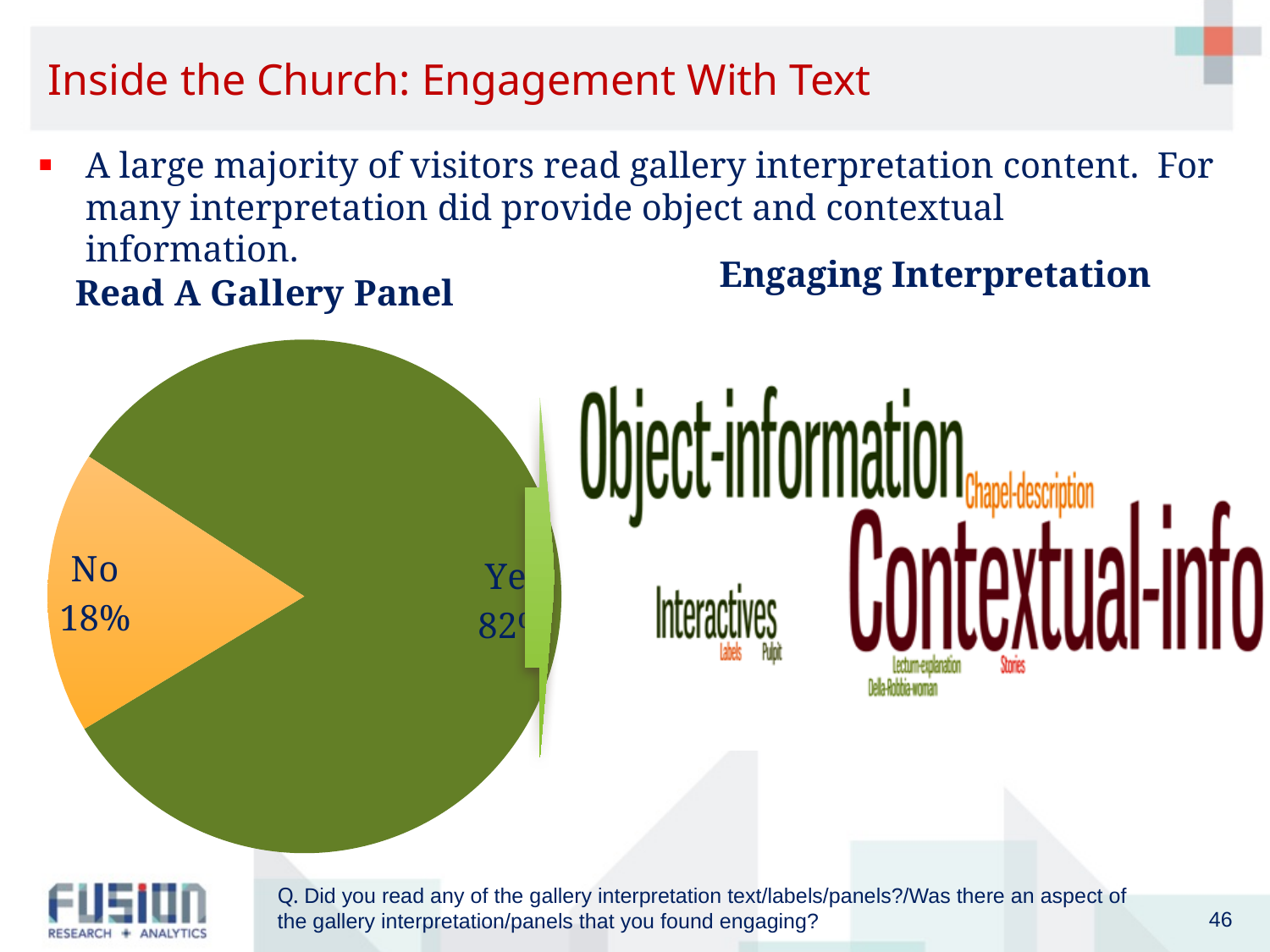
In the 'Read A Gallery Panel' pie chart, which is larger, the Yes slice or the No slice? Yes What is the title of the pie chart on the left of the slide? Read A Gallery Panel What kind of chart is the 'Read A Gallery Panel' chart? pie chart In the 'Read A Gallery Panel' pie chart, which response has the largest slice? Yes What colour is the No slice in the 'Read A Gallery Panel' pie chart? orange In the 'Read A Gallery Panel' pie chart, what is the difference in percentage points between Yes and No? 64 In the 'Read A Gallery Panel' pie chart, what percentage of visitors answered Yes? 82% In the 'Read A Gallery Panel' pie chart, what percentage of visitors answered No? 18% How many slices does the 'Read A Gallery Panel' pie chart have? 2 In the 'Read A Gallery Panel' pie chart, which response has the smallest slice? No What share of the 'Read A Gallery Panel' pie does the No slice represent? 18%